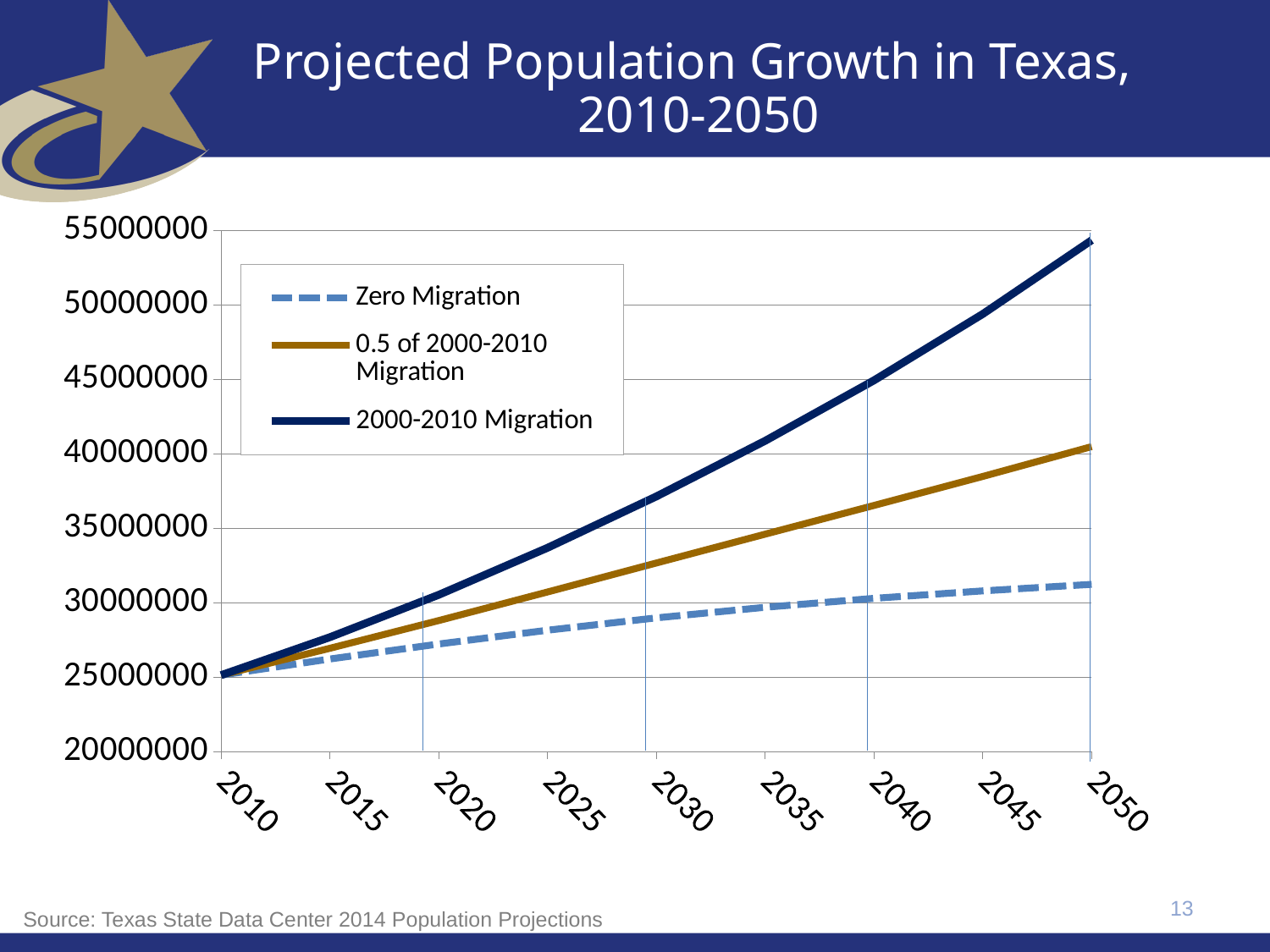
Is the value for 0.5 of 2000-2010 Migration in 2050 greater or less than 45000000? less How many years are labelled along the x axis? 9 Is the value for 2000-2010 Migration in 2050 greater or less than 50000000? greater Which series is drawn with a dashed line? Zero Migration What kind of chart is shown on the slide? line chart Which series has the lowest value in 2050? Zero Migration Which series has the highest value in 2050? 2000-2010 Migration Is the value for Zero Migration in 2030 greater or less than 30000000? less How many series does the legend list? 3 Which is larger in 2040, the value for 0.5 of 2000-2010 Migration or the value for Zero Migration? 0.5 of 2000-2010 Migration Do the values for the 2000-2010 Migration series rise or fall from 2010 to 2050? rise